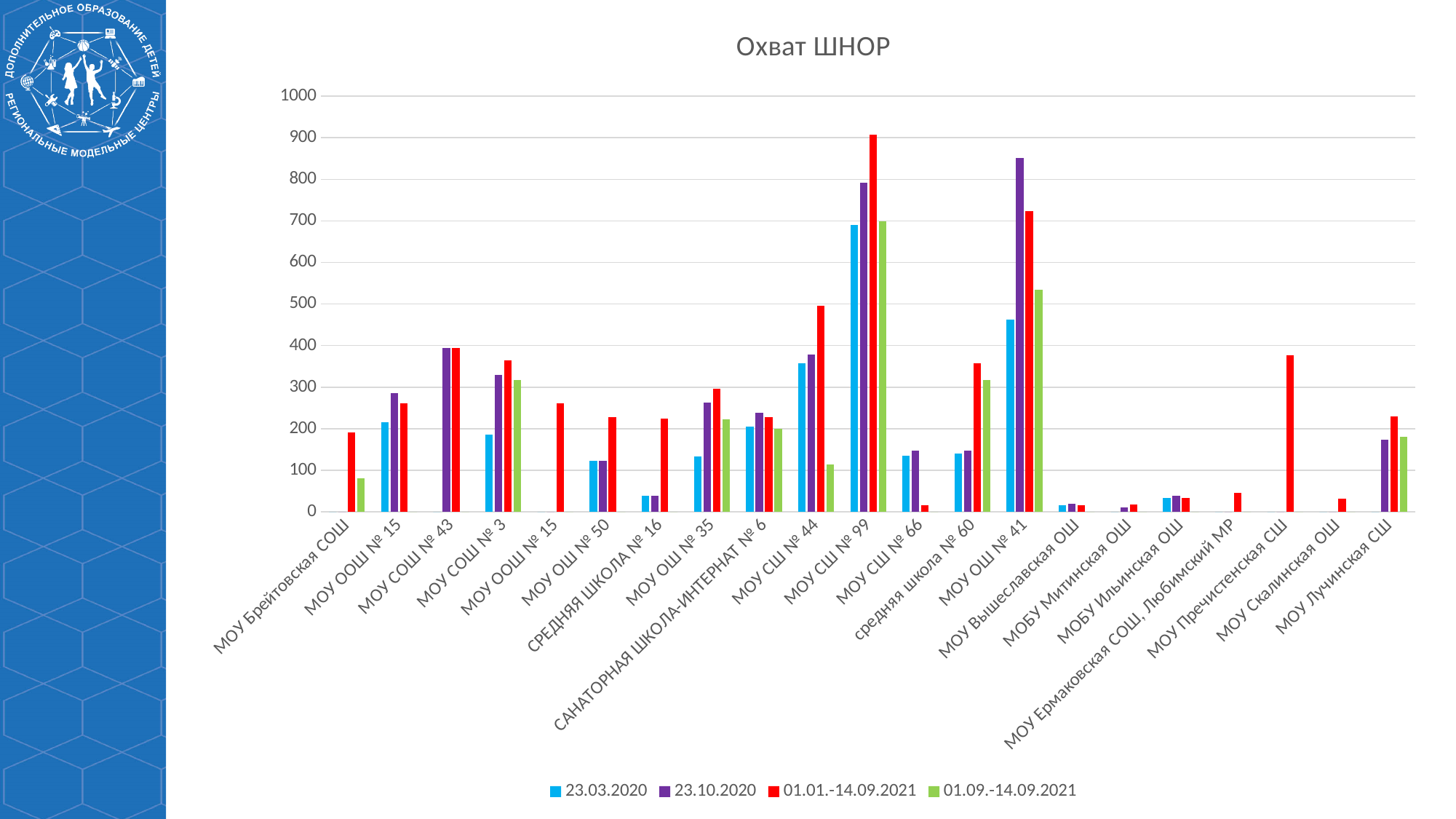
What type of chart is shown on the slide? bar chart Is the 01.01.-14.09.2021 value for МОУ СШ № 99 greater or less than 800? greater For the 01.01.-14.09.2021 series, which is larger: МОУ СШ № 99 or МОУ ОШ № 41? МОУ СШ № 99 What is the title of the chart? Охват ШНОР Which school has the highest value for the 01.01.-14.09.2021 series? МОУ СШ № 99 Which school has the highest value for the 23.03.2020 series? МОУ СШ № 99 How many series does the legend list? 4 For the 23.10.2020 series, which is larger: МОУ СШ № 99 or МОУ ОШ № 41? МОУ ОШ № 41 How many school categories are shown on the x axis? 21 Is the 01.01.-14.09.2021 value for МОУ Пречистенская СШ greater or less than 400? less Which school has the highest value for the 23.10.2020 series? МОУ ОШ № 41 Is the 23.10.2020 value for МОУ ОШ № 41 greater or less than 800? greater